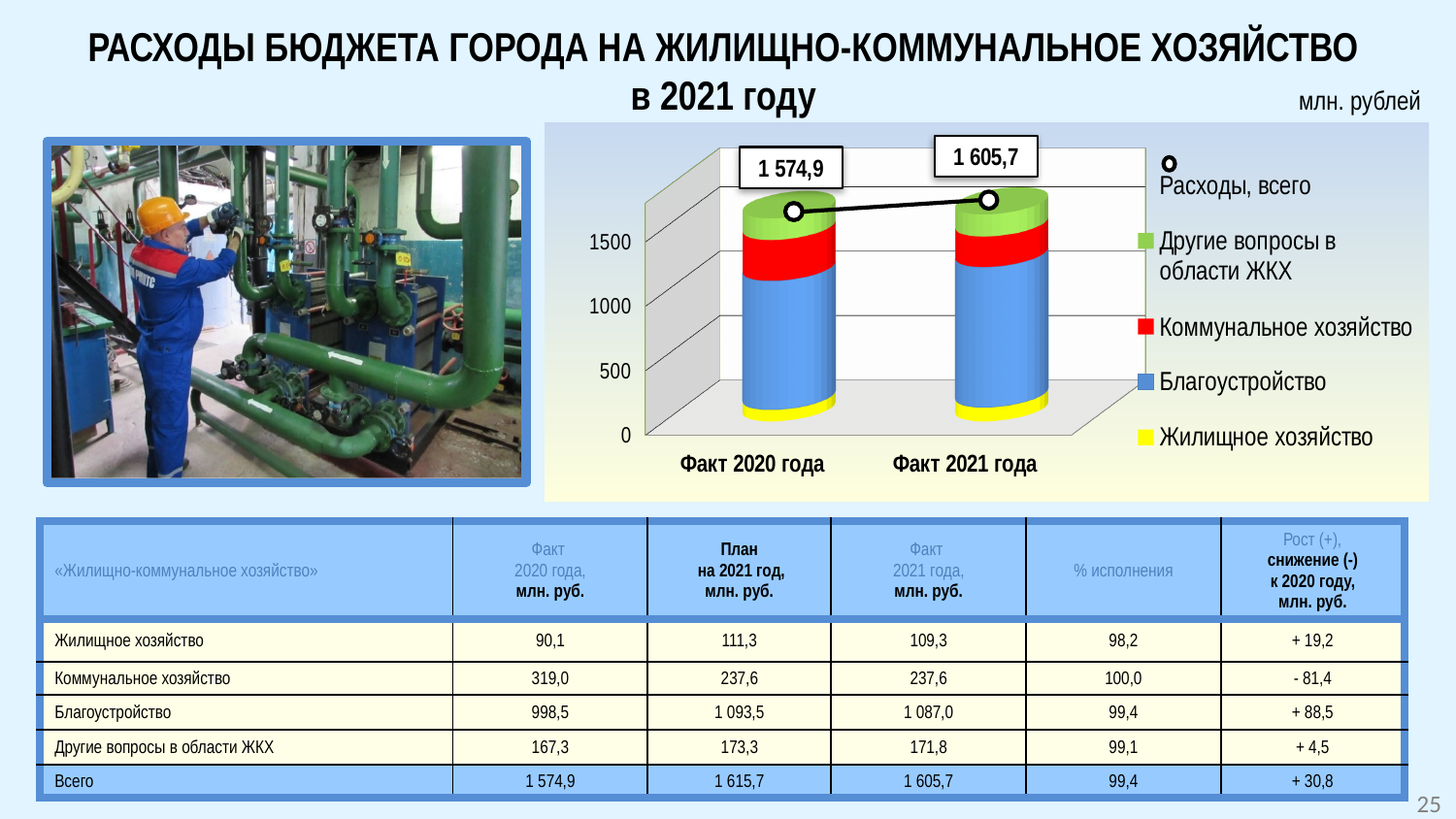
Which category has the lowest value of Расходы, всего? Факт 2020 года How many categories are shown on the x axis of the chart? 2 By how much does Расходы, всего for Факт 2021 года exceed Расходы, всего for Факт 2020 года? 30,8 How many series does the chart legend list? 5 Which category has the highest value of Расходы, всего? Факт 2021 года What is the value of Расходы, всего for Факт 2020 года? 1 574,9 What is the value of Расходы, всего for Факт 2021 года? 1 605,7 Does Расходы, всего rise or fall from Факт 2020 года to Факт 2021 года? rise Is the value of Расходы, всего for Факт 2020 года greater or less than 1500? greater Which legend entry is plotted as a line with markers rather than as a bar segment? Расходы, всего Which is larger: Расходы, всего for Факт 2020 года or for Факт 2021 года? Факт 2021 года What kind of chart is shown on the slide? bar chart